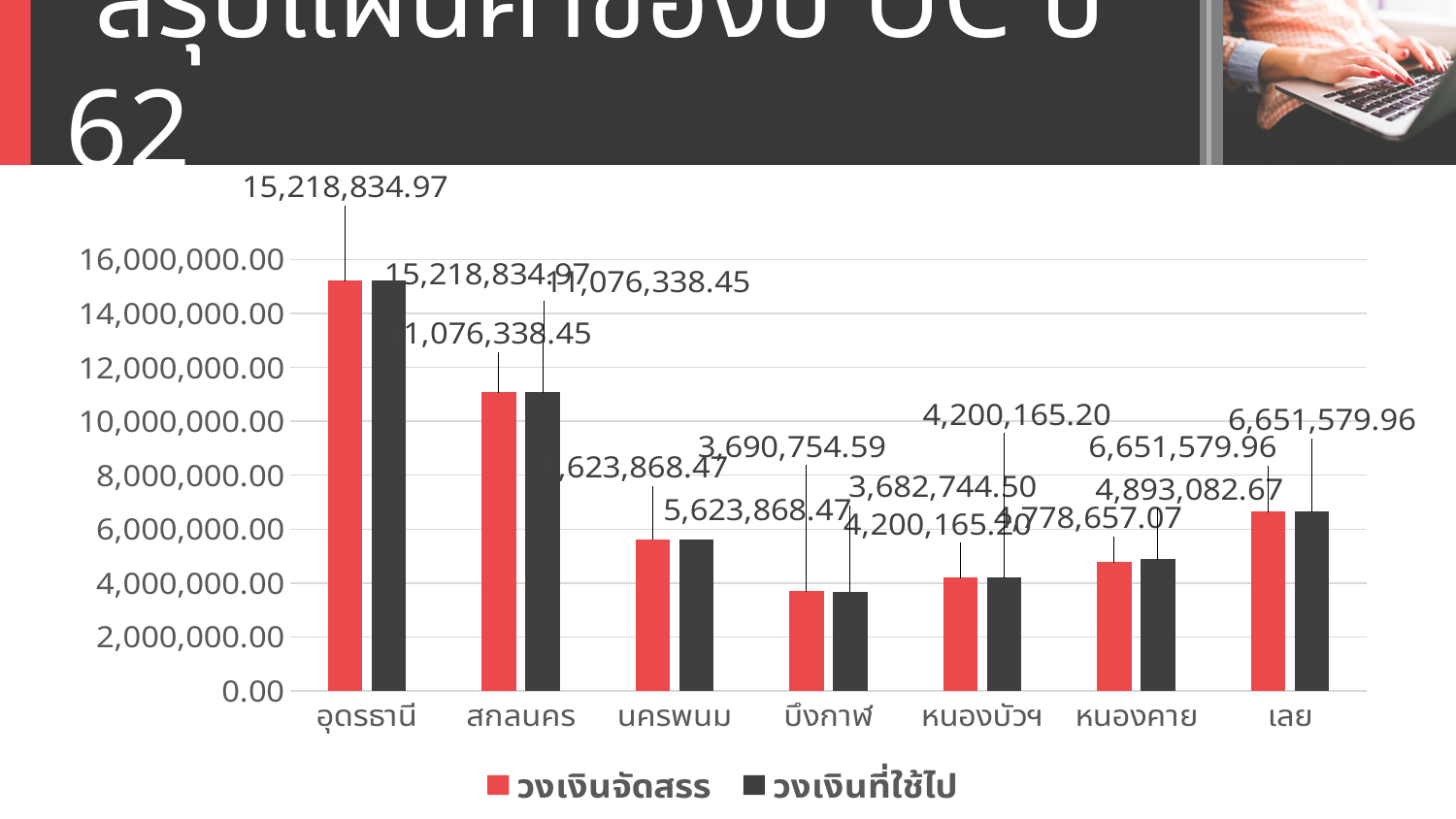
What type of chart is shown on the slide? bar chart Which series is shown in red in the legend? วงเงินจัดสรร What is the value of วงเงินจัดสรร for อุดรธานี? 15,218,834.97 What is the value of วงเงินที่ใช้ไป for สกลนคร? 11,076,338.45 Which is larger, the วงเงินจัดสรร for เลย or for นครพนม? เลย What is the value of วงเงินจัดสรร for หนองคาย? 4,778,657.07 What is the difference between วงเงินที่ใช้ไป and วงเงินจัดสรร for หนองคาย? 114,425.60 What is the value of วงเงินที่ใช้ไป for บึงกาฬ? 3,682,744.50 Which category has the highest วงเงินจัดสรร? อุดรธานี How many categories are shown on the x axis? 7 Which category has the lowest วงเงินที่ใช้ไป? บึงกาฬ How many series does the legend list? 2